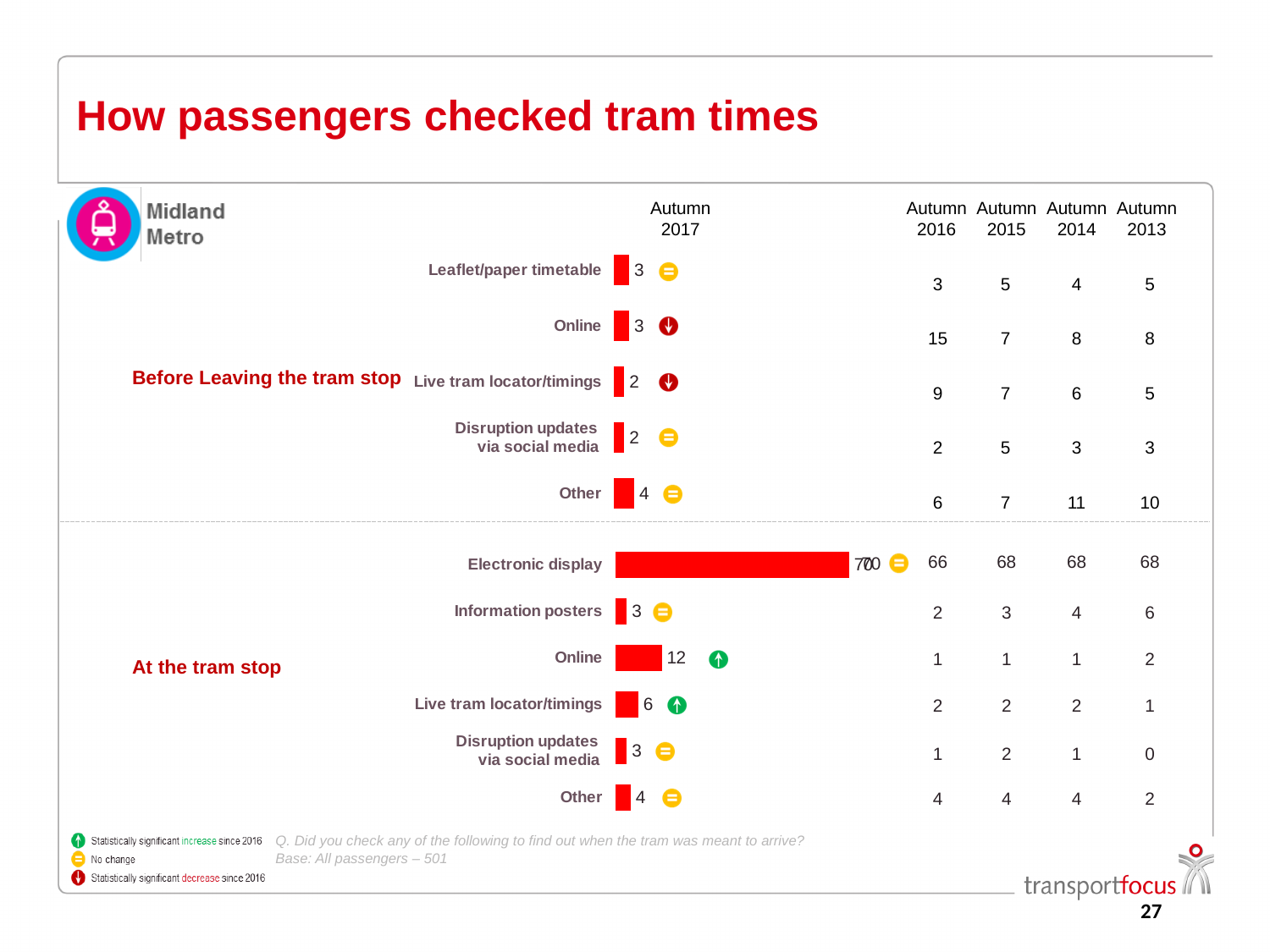
How many categories are shown in the 'At the tram stop' chart? 6 In the 'At the tram stop' chart, which category has the highest Autumn 2017 value? Electronic display In the 'Before Leaving the tram stop' chart, which category has the highest Autumn 2017 value? Other In the 'At the tram stop' chart, what is the difference between the Autumn 2017 values for Online and Live tram locator/timings? 6 According to the table, what was the value for Online in the 'Before Leaving the tram stop' section in Autumn 2016? 15 How many categories are shown in the 'Before Leaving the tram stop' chart? 5 What kind of chart is used to show the Autumn 2017 values on this slide? Bar chart In the 'At the tram stop' chart, what is the Autumn 2017 value for Online? 12 In the 'Before Leaving the tram stop' chart, what is the Autumn 2017 value for Other? 4 In the 'Before Leaving the tram stop' chart, what is the Autumn 2017 value for Live tram locator/timings? 2 In the 'At the tram stop' chart, what is the Autumn 2017 value for Live tram locator/timings? 6 In the 'At the tram stop' chart, which has the larger Autumn 2017 value: Online or Other? Online